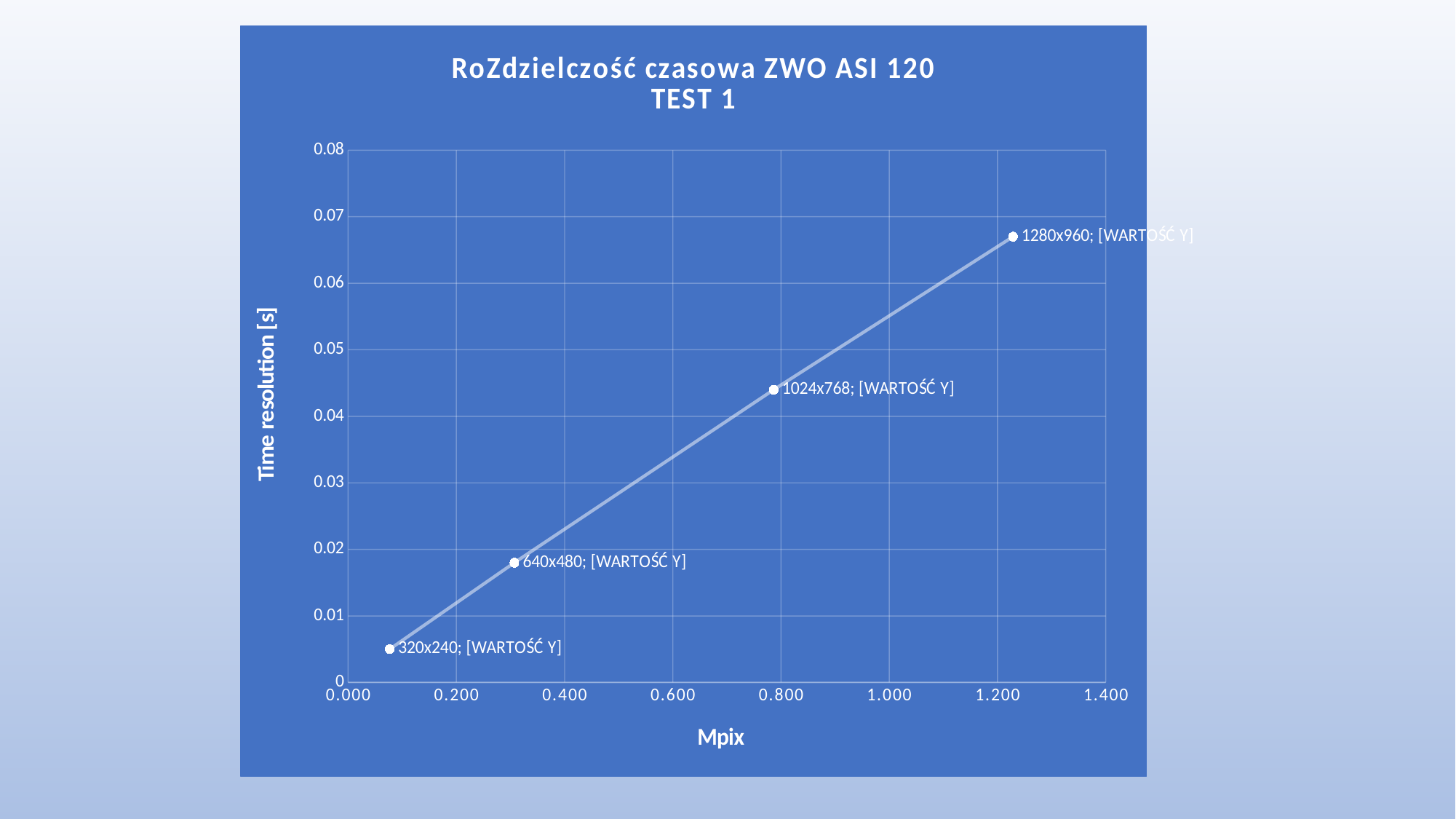
What is the title of the chart? RoZdzielczość czasowa ZWO ASI 120 TEST 1 Which resolution has the lowest time resolution value? 320x240 Is the time resolution value for 320x240 greater or less than 0.01? less Do the values rise or fall as Mpix increases along the x axis? rise What kind of chart is shown on the slide? line chart Is the time resolution value for 1024x768 greater or less than 0.04? greater Is the time resolution value for 1280x960 greater or less than 0.06? greater How many data points are plotted on the chart? 4 Which has a larger time resolution value, 640x480 or 1024x768? 1024x768 Which resolution has the highest time resolution value? 1280x960 What is the label of the y axis? Time resolution [s]